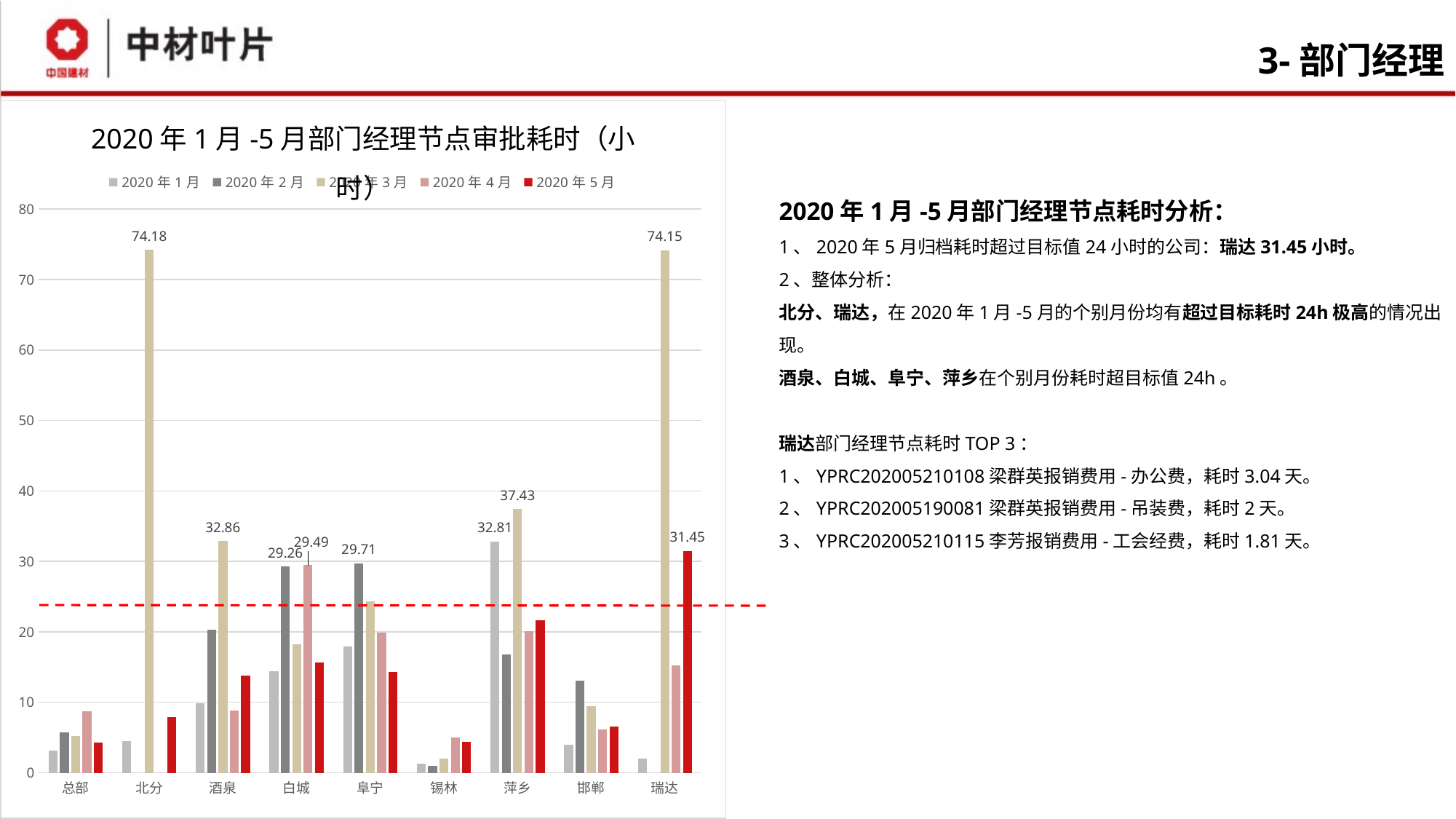
What kind of chart is shown on the slide? Bar chart How many categories are shown on the x axis? 9 Which category has the highest value in the 2020年3月 series? 北分 What is the value for 北分 in the 2020年3月 series? 74.18 For 白城, which series has the larger value: 2020年2月 or 2020年4月? 2020年4月 Is the value for 邯郸 in the 2020年2月 series greater or less than 10? greater What is the value for 萍乡 in the 2020年3月 series? 37.43 What is the value for 瑞达 in the 2020年5月 series? 31.45 What is the value for 酒泉 in the 2020年3月 series? 32.86 What is the difference between the 2020年3月 values for 北分 and 瑞达? 0.03 For 萍乡, how much larger is the 2020年3月 value than the 2020年1月 value? 4.62 How many series does the legend list? 5